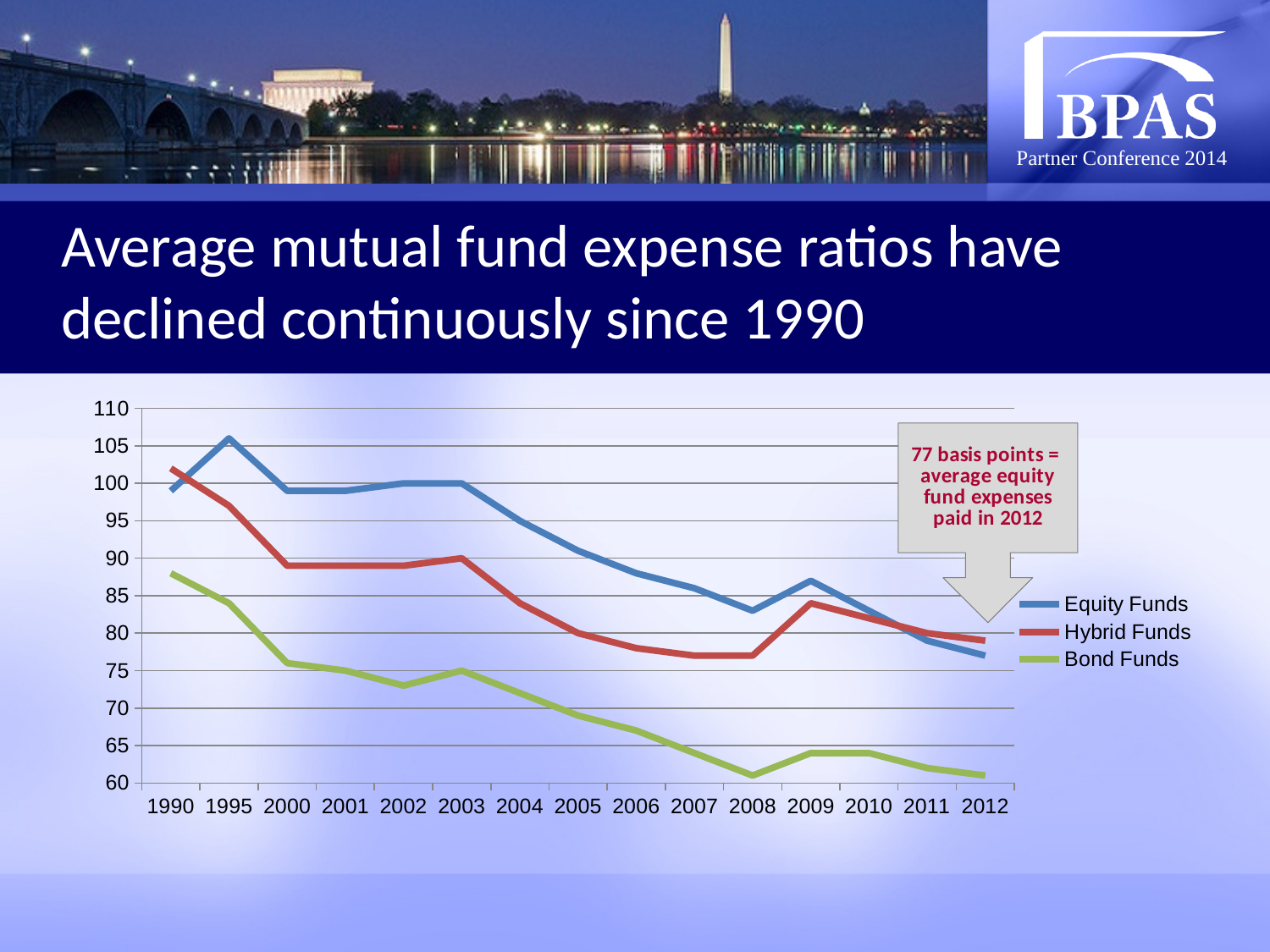
According to the callout, what was the average equity fund expense ratio in 2012, in basis points? 77 What kind of chart is shown on the slide? line chart In which year does the Equity Funds line reach its highest value? 1995 What colour is the Bond Funds line? green Do the Bond Funds values generally rise or fall from 1990 to 2012? fall Is the value for Hybrid Funds in 2007 greater or less than 80? less How many series does the legend list? 3 Which series has the lowest values across the whole chart? Bond Funds In 2003, which is larger: Equity Funds or Hybrid Funds? Equity Funds Is the value for Equity Funds in 2008 greater or less than 85? less Is the value for Bond Funds in 1990 greater or less than 85? greater How many years are shown along the x axis? 15